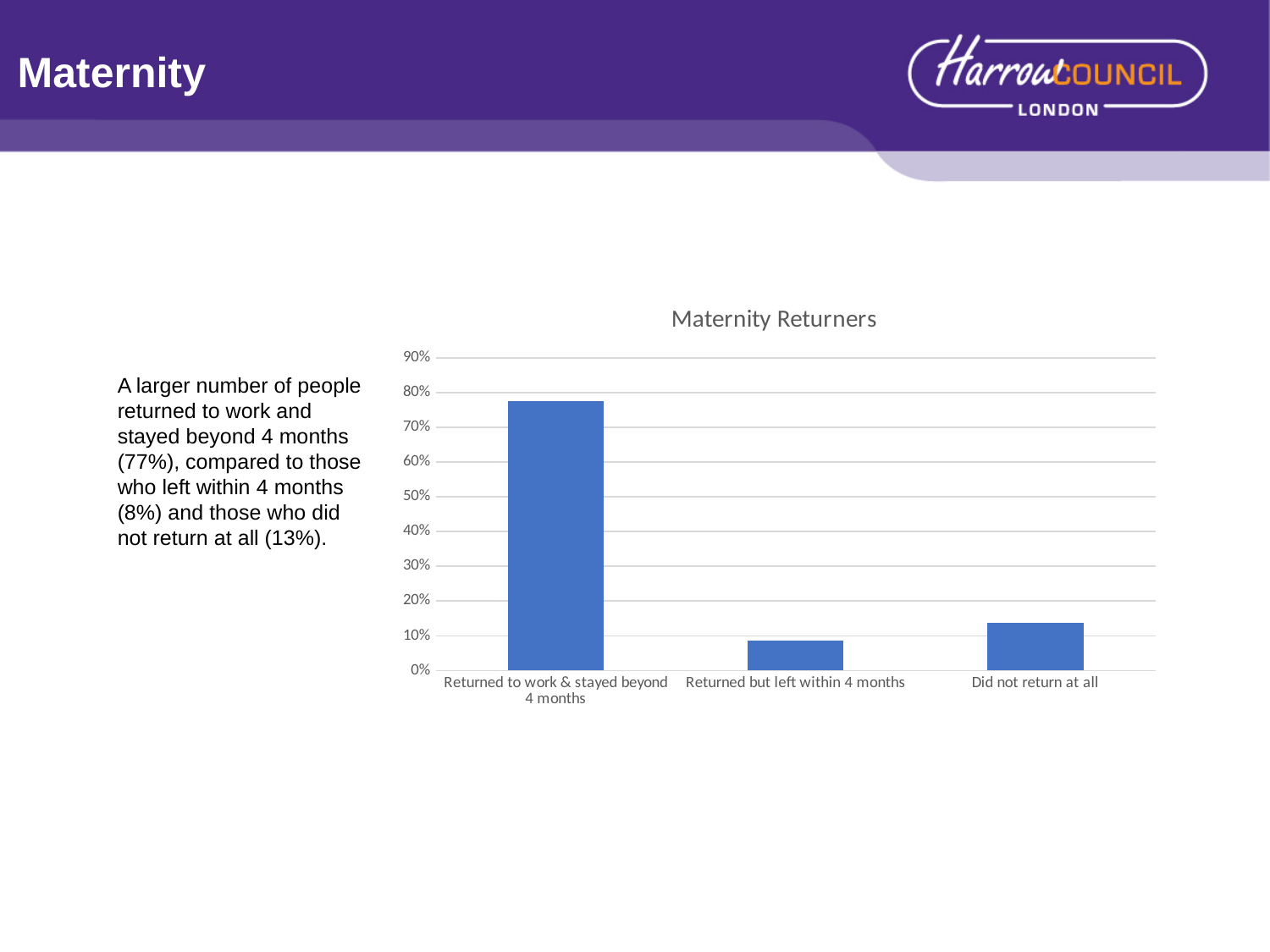
According to the slide text, what percentage of people did not return at all? 13% What is the highest value shown on the chart's y axis? 90% Which category has the highest value in the chart? Returned to work & stayed beyond 4 months Which is larger: the value for 'Did not return at all' or the value for 'Returned but left within 4 months'? Did not return at all Is the value for 'Did not return at all' greater or less than 10%? greater What is the title of the chart? Maternity Returners What type of chart is shown on the slide? bar chart Is the value for 'Returned to work & stayed beyond 4 months' greater or less than 70%? greater Which category has the lowest value in the chart? Returned but left within 4 months According to the slide text, what percentage of people returned to work and stayed beyond 4 months? 77% How many categories are shown on the x axis of the chart? 3 Is the value for 'Returned but left within 4 months' greater or less than 10%? less